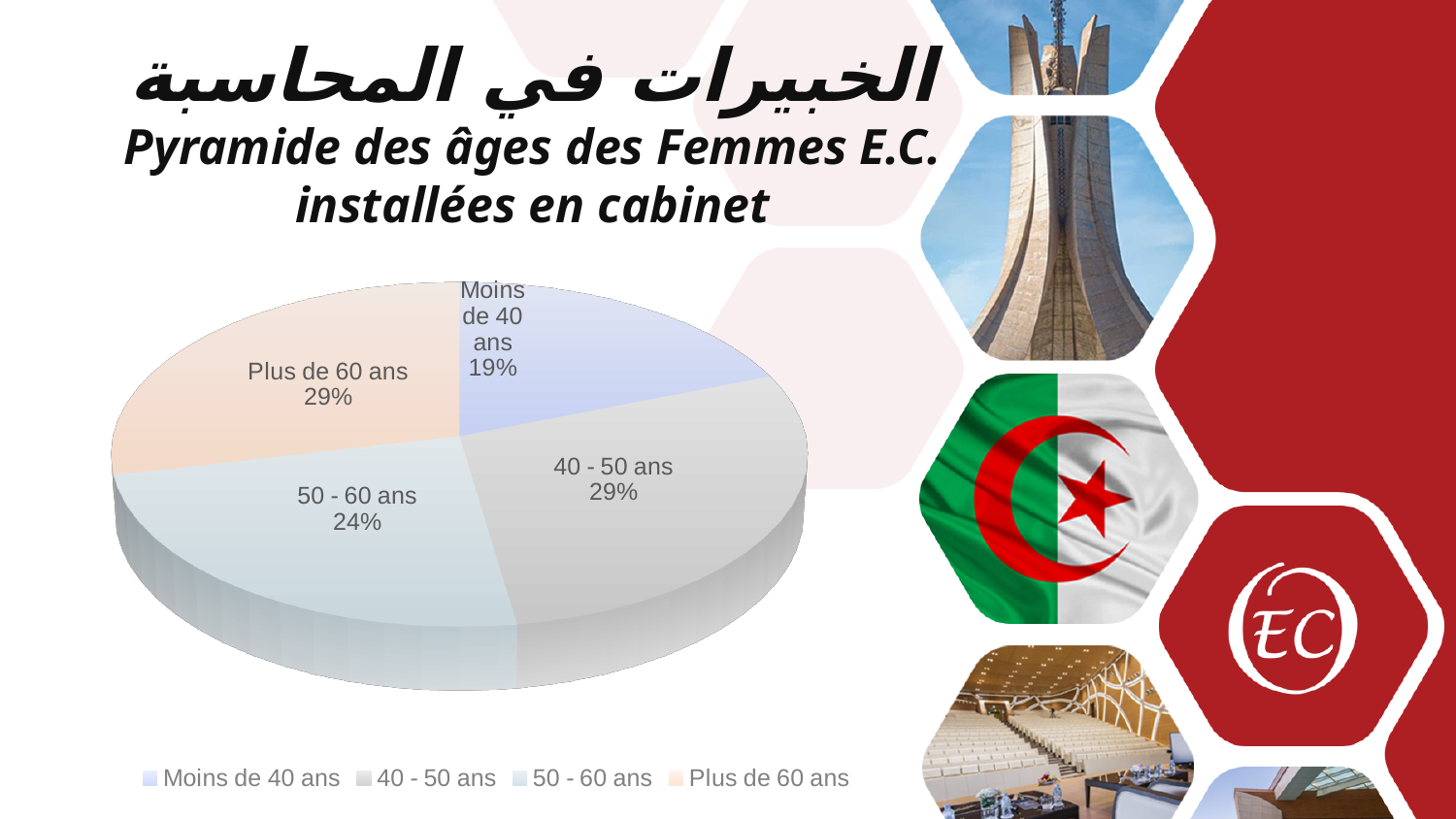
What is the French title of the chart on the slide? Pyramide des âges des Femmes E.C. installées en cabinet How many entries does the legend list? 4 What kind of chart is shown on the slide? Pie chart What share of the pie is the 'Plus de 60 ans' slice? 29% What is the difference in percentage points between the '40 - 50 ans' slice and the 'Moins de 40 ans' slice? 10 What share of the pie is the '40 - 50 ans' slice? 29% What is the difference in percentage points between the '50 - 60 ans' slice and the 'Moins de 40 ans' slice? 5 How many slices does the pie chart have? 4 What share of the pie is the 'Moins de 40 ans' slice? 19% Which age group has the smallest share of the pie? Moins de 40 ans Which is larger, the share for '50 - 60 ans' or the share for 'Plus de 60 ans'? Plus de 60 ans